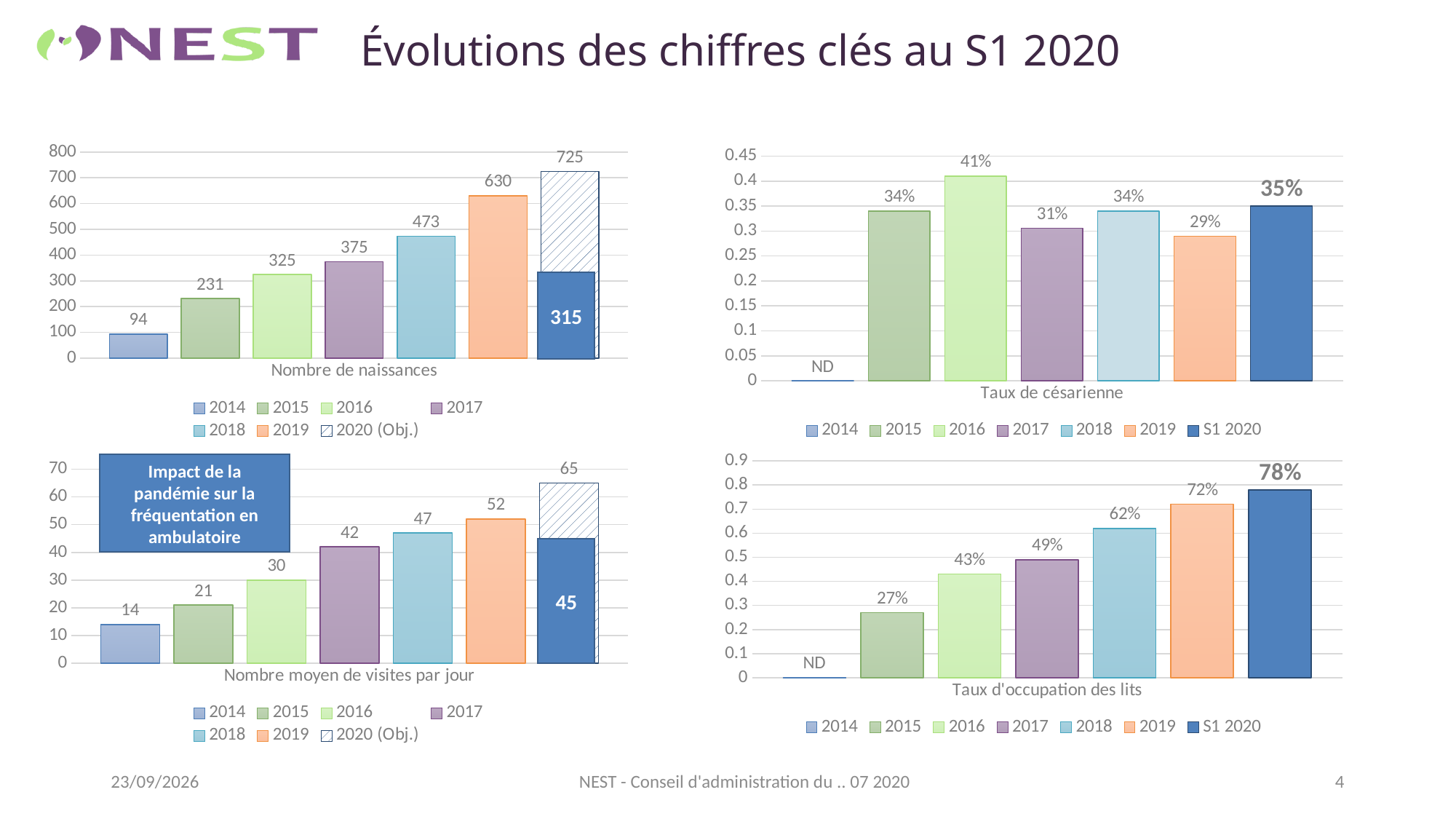
In the 'Taux de césarienne' chart, what is the value shown for S1 2020? 35% In the 'Taux de césarienne' chart, what is the value for 2016? 41% In the 'Nombre moyen de visites par jour' chart, is the value for 2019 larger or smaller than the value for 2018? larger In the 'Taux d'occupation des lits' chart, do the values rise or fall from 2015 to S1 2020? rise In the 'Taux de césarienne' chart, which year has the highest rate? 2016 In the 'Nombre de naissances' chart, what is the 2020 objective value? 725 In the 'Nombre de naissances' chart, which year has the lowest value? 2014 In the 'Nombre moyen de visites par jour' chart, what is the value for 2017? 42 In the 'Taux d'occupation des lits' chart, what is the value for 2018? 62% In the 'Nombre de naissances' chart, what is the difference between the 2019 value and the 2018 value? 157 How many entries does the legend of the 'Taux d'occupation des lits' chart list? 7 In the 'Nombre de naissances' chart, what is the value for 2019? 630